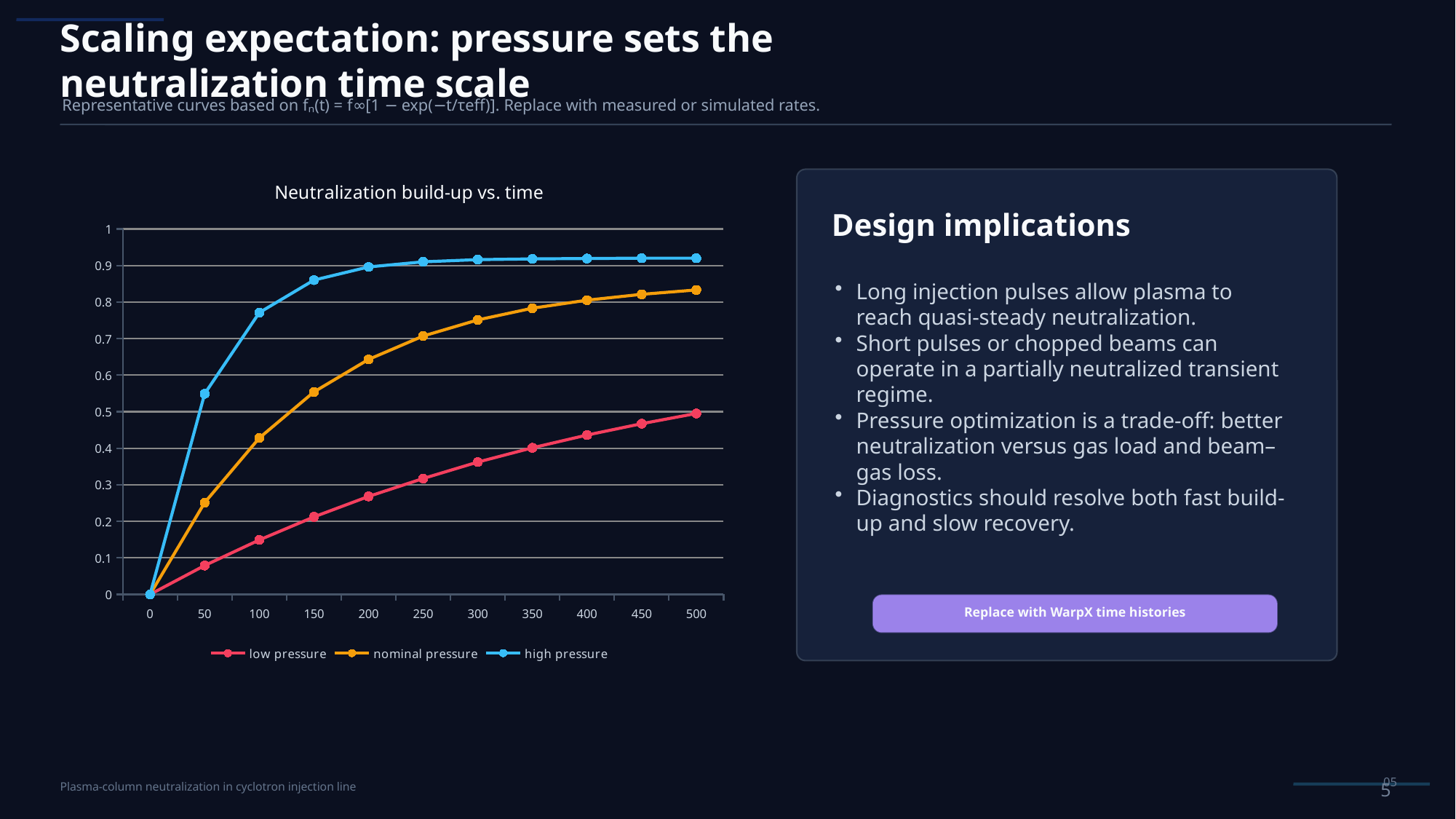
What kind of chart is shown on the slide? line chart Is the value for high pressure at time 100 greater or less than 0.8? less Which series has the lowest value at time 250? low pressure What is the title of the chart? Neutralization build-up vs. time Is the value for nominal pressure at time 500 greater or less than 0.8? greater What is the value of the high pressure series at time 0? 0 How many time points are plotted along the x axis for each series? 11 Is the value for high pressure at time 500 greater or less than 0.9? greater Do the values of the low pressure series rise or fall as time increases along the x axis? rise Which series has the highest value at time 500? high pressure At time 200, which is larger: the nominal pressure value or the low pressure value? nominal pressure How many series does the chart legend list? 3